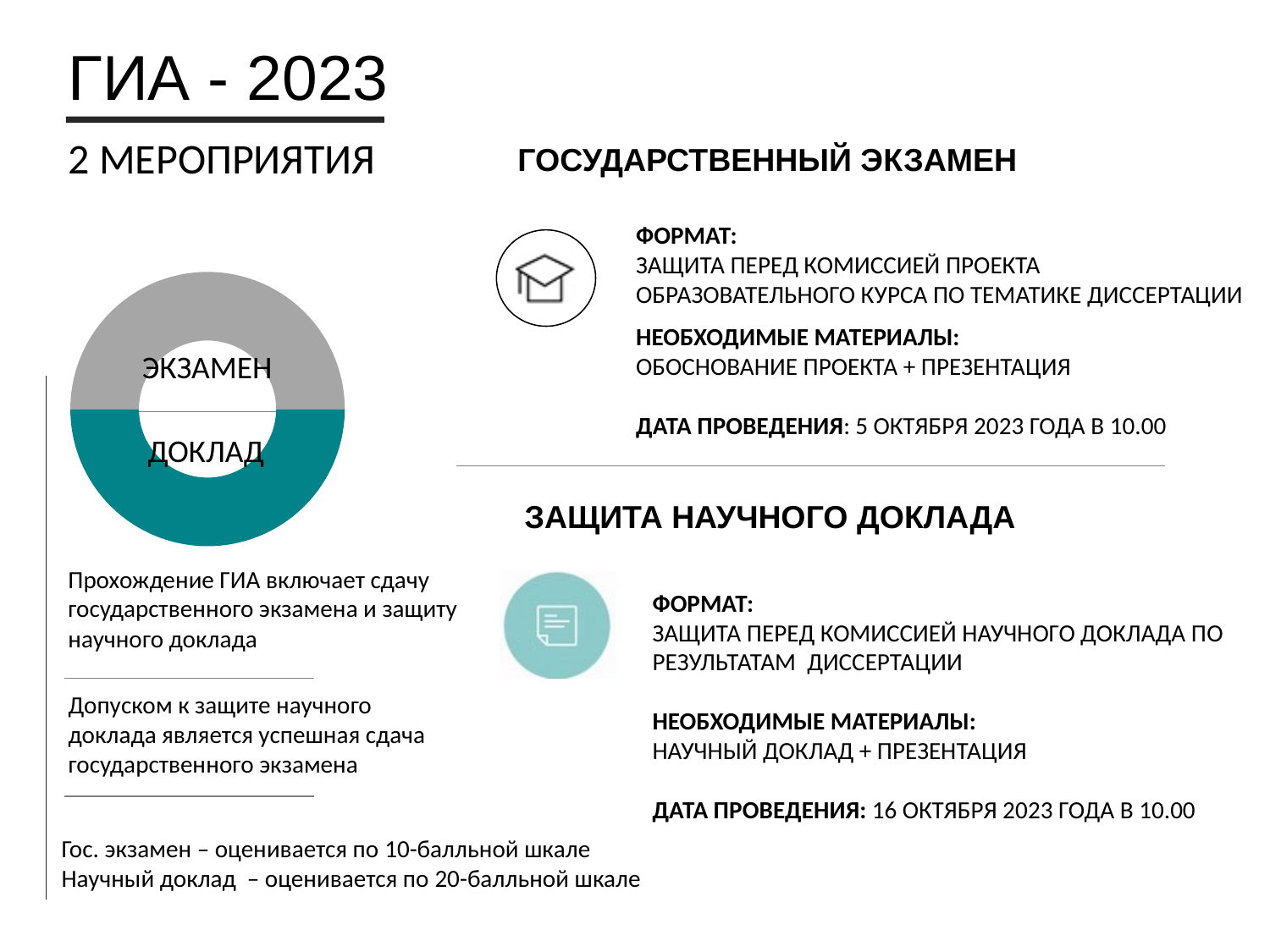
What are the labels of the two segments in the doughnut chart? ЭКЗАМЕН and ДОКЛАД Which segment occupies the upper half of the doughnut chart? ЭКЗАМЕН How many segments does the doughnut chart have? 2 What colour is the ДОКЛАД segment of the doughnut chart? teal What kind of chart is shown on the left of the slide? doughnut chart